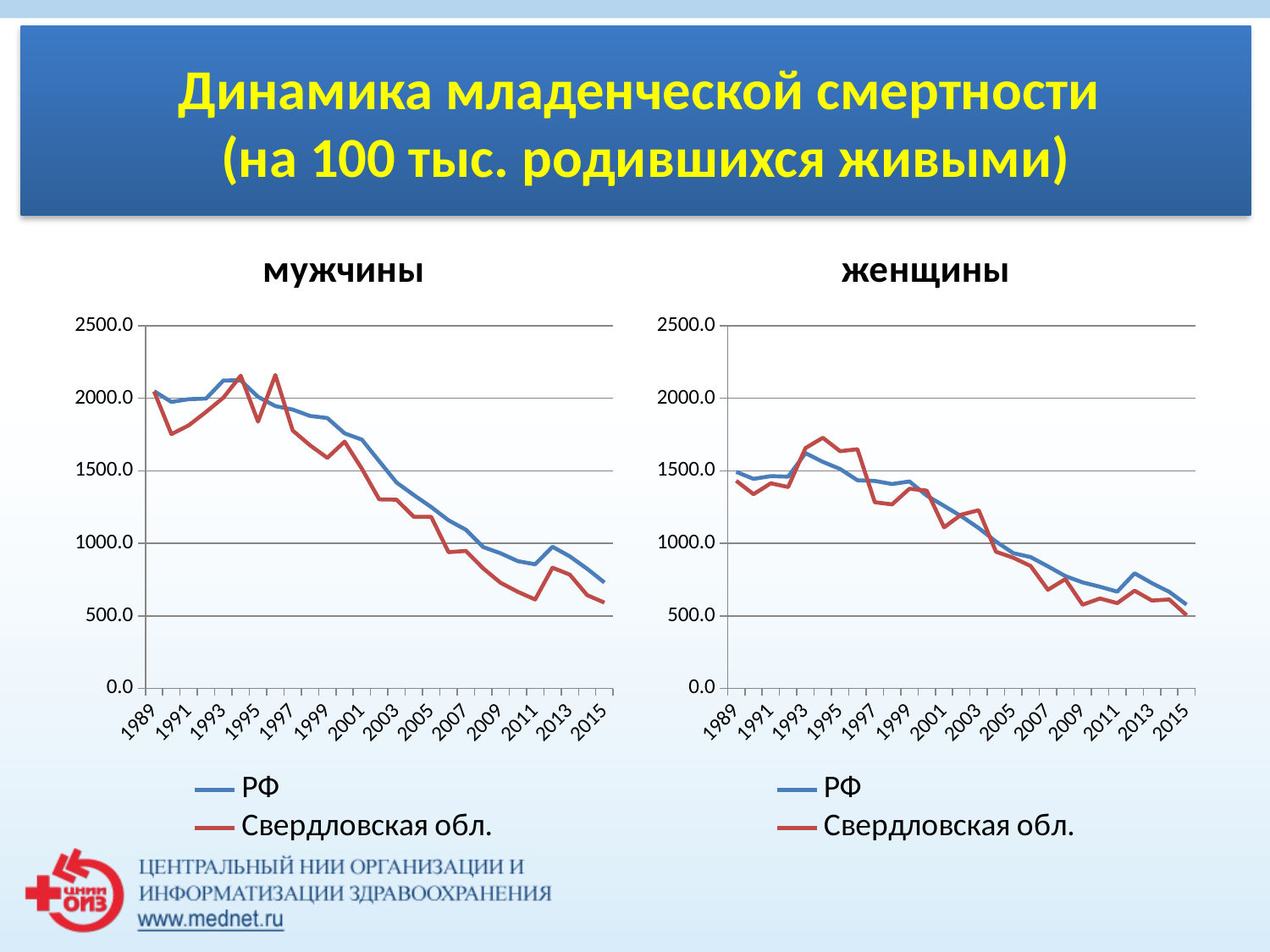
What is the title of the chart on the right side of the slide? женщины In the "женщины" chart, is the value for Свердловская обл. in 1994 greater or less than 1500.0? greater In the "мужчины" chart, is the value for РФ in 2001 greater or less than 1500.0? greater In the "мужчины" chart, which series has the higher value in 2015, РФ or Свердловская обл.? РФ What kind of chart is the "мужчины" chart? line chart What are the two series named in the legend of the "мужчины" chart? РФ and Свердловская обл. How many series does the legend of the "женщины" chart list? 2 In the "мужчины" chart, do the values for РФ rise or fall overall from 1989 to 2015? fall In the "женщины" chart, which series has the higher value in 2015, РФ or Свердловская обл.? РФ In the "женщины" chart, do the values for Свердловская обл. rise or fall overall from 1989 to 2015? fall In the "мужчины" chart, is the value for Свердловская обл. in 2011 greater or less than 1000.0? less